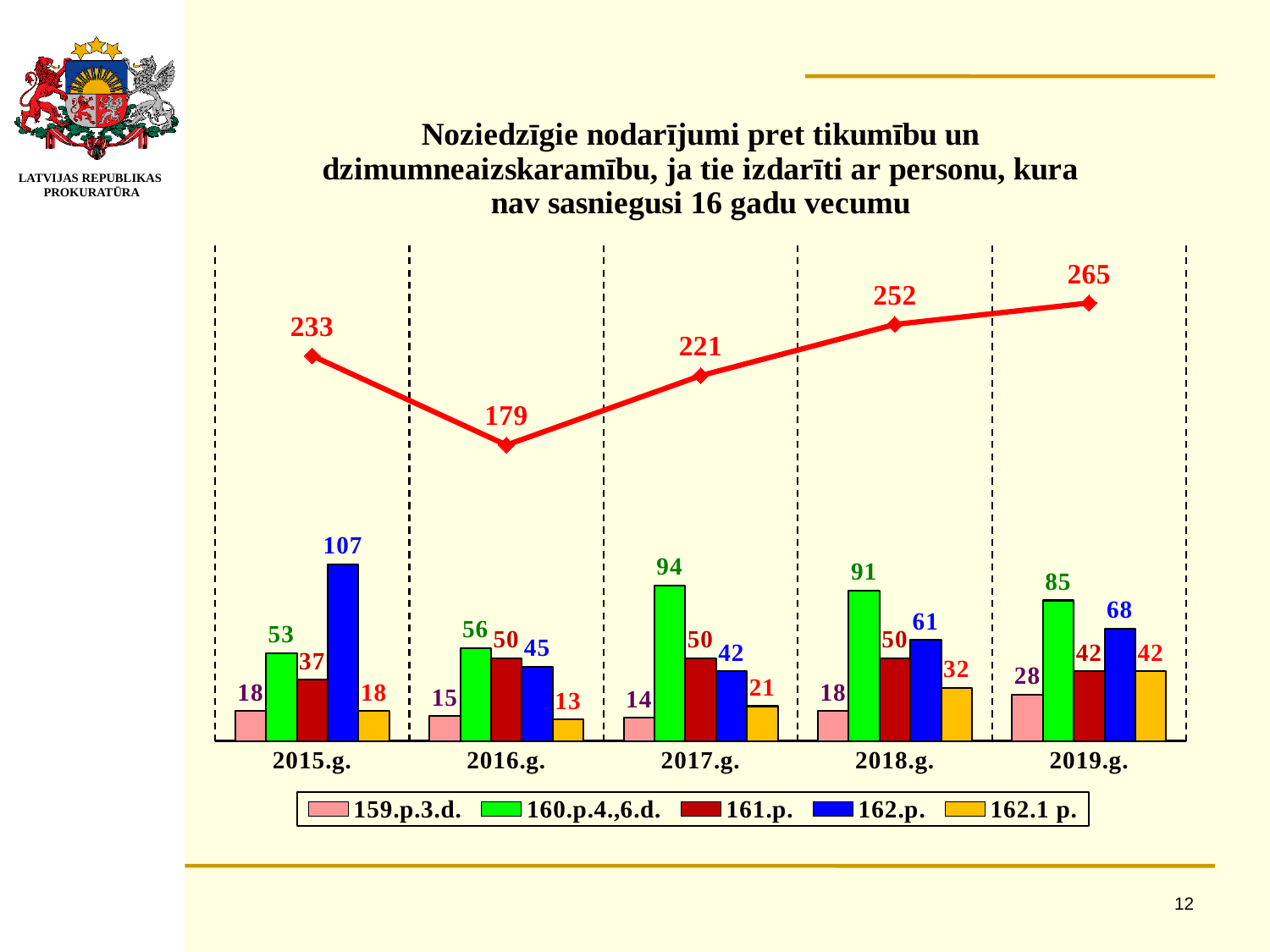
What is the value of the 160.p.4.,6.d. bar for 2017.g.? 94 In which year does the red line reach its highest value? 2019.g. Which colour represents the 161.p. series in the legend? dark red Which is larger: the 162.p. bar for 2018.g. or the 162.p. bar for 2019.g.? 2019.g. What is the value of the 162.1 p. bar for 2019.g.? 42 How many years are shown on the x axis? 5 What is the difference between the red line values for 2019.g. and 2015.g.? 32 What is the value of the 162.p. bar for 2015.g.? 107 What is the value of the red line for 2016.g.? 179 How many series does the legend list? 5 Does the red line rise or fall from 2016.g. to 2019.g.? rises In which year does the red line reach its lowest value? 2016.g.